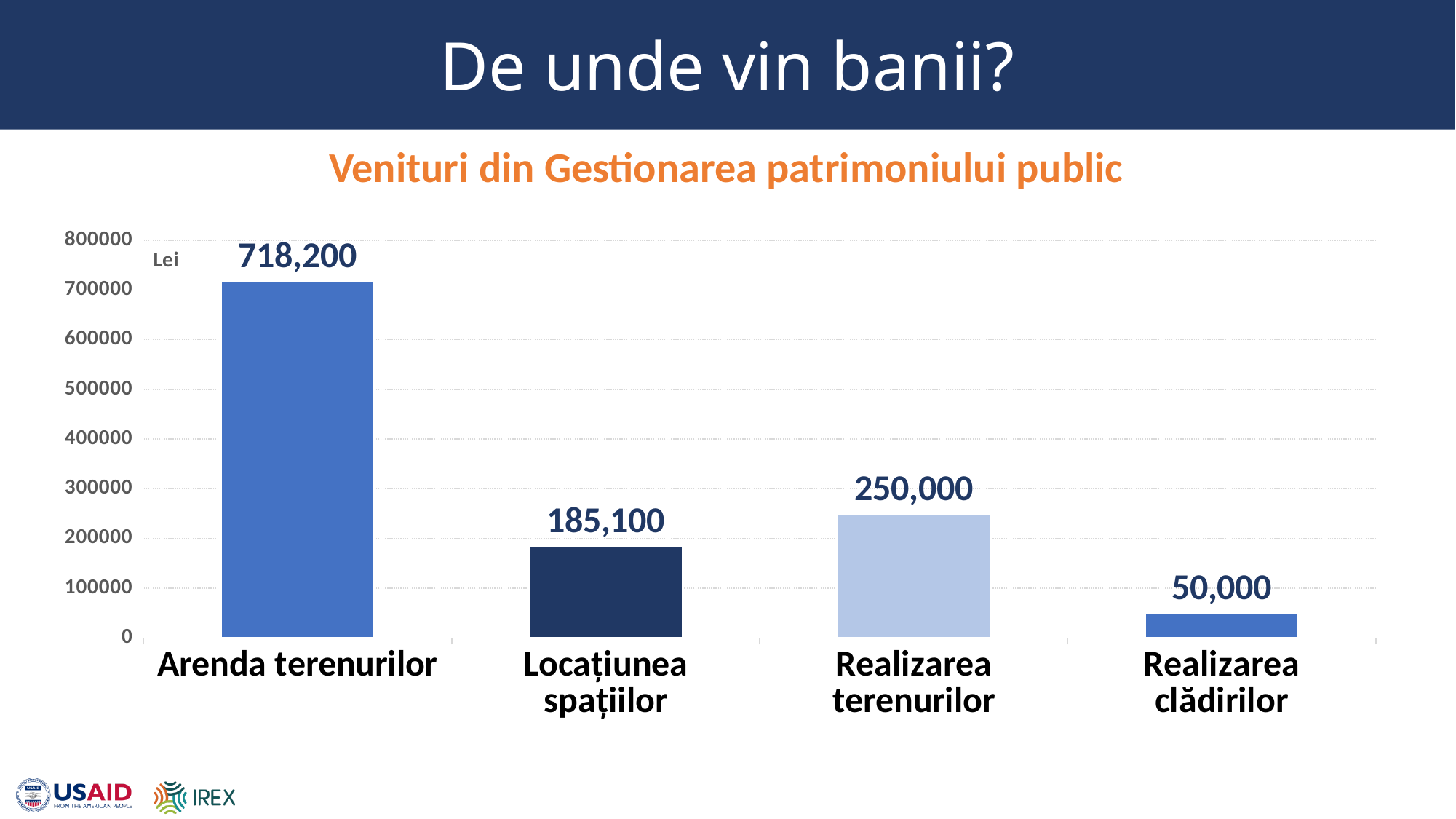
What is the title of the chart? Venituri din Gestionarea patrimoniului public What is the value for Arenda terenurilor? 718,200 What is the value for Locațiunea spațiilor? 185,100 Which is larger, the value for Locațiunea spațiilor or the value for Realizarea terenurilor? Realizarea terenurilor Is the value for Locațiunea spațiilor greater or less than 200000? less Which category has the highest value? Arenda terenurilor What is the difference between the values for Arenda terenurilor and Realizarea terenurilor? 468,200 How many categories are shown in the chart? 4 What kind of chart is shown on the slide? bar chart Which category has the lowest value? Realizarea clădirilor What is the value for Realizarea clădirilor? 50,000 What is the value for Realizarea terenurilor? 250,000